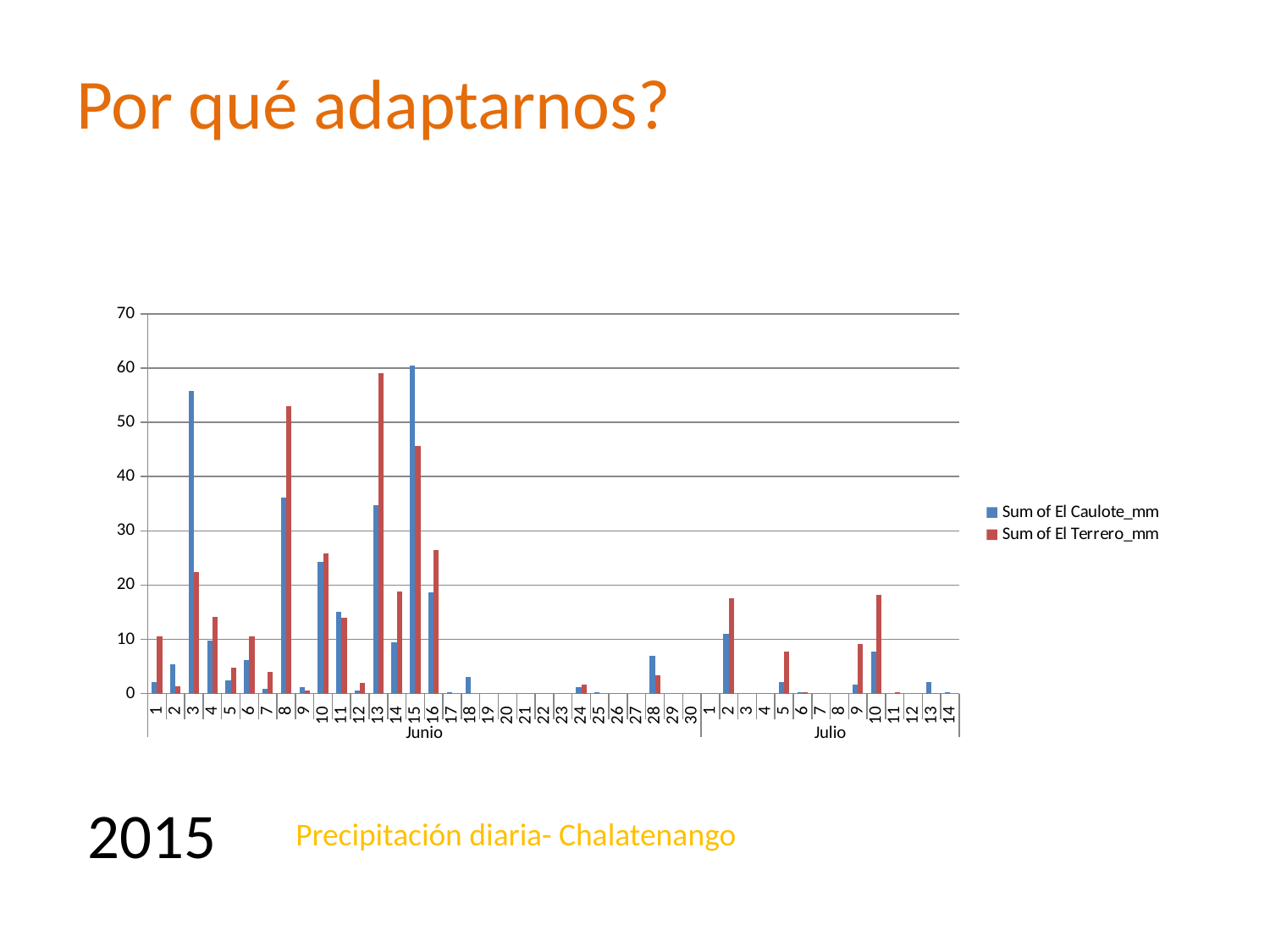
Is the Sum of El Terrero_mm value on Junio 8 greater or less than 50? greater How many days (categories) are plotted on the x axis in total? 44 On Junio 3, which series has the larger value, Sum of El Caulote_mm or Sum of El Terrero_mm? Sum of El Caulote_mm On which day is the Sum of El Caulote_mm value highest? Junio 15 What are the two series named in the legend? Sum of El Caulote_mm and Sum of El Terrero_mm On Junio 13, which series has the larger value, Sum of El Caulote_mm or Sum of El Terrero_mm? Sum of El Terrero_mm What kind of chart is shown on the slide? bar chart Is the Sum of El Terrero_mm value on Julio 10 greater or less than 20? less Which two months are shown on the x axis? Junio and Julio Is the Sum of El Caulote_mm value on Junio 3 greater or less than 50? greater How many series does the legend list? 2 On which day is the Sum of El Terrero_mm value highest? Junio 13